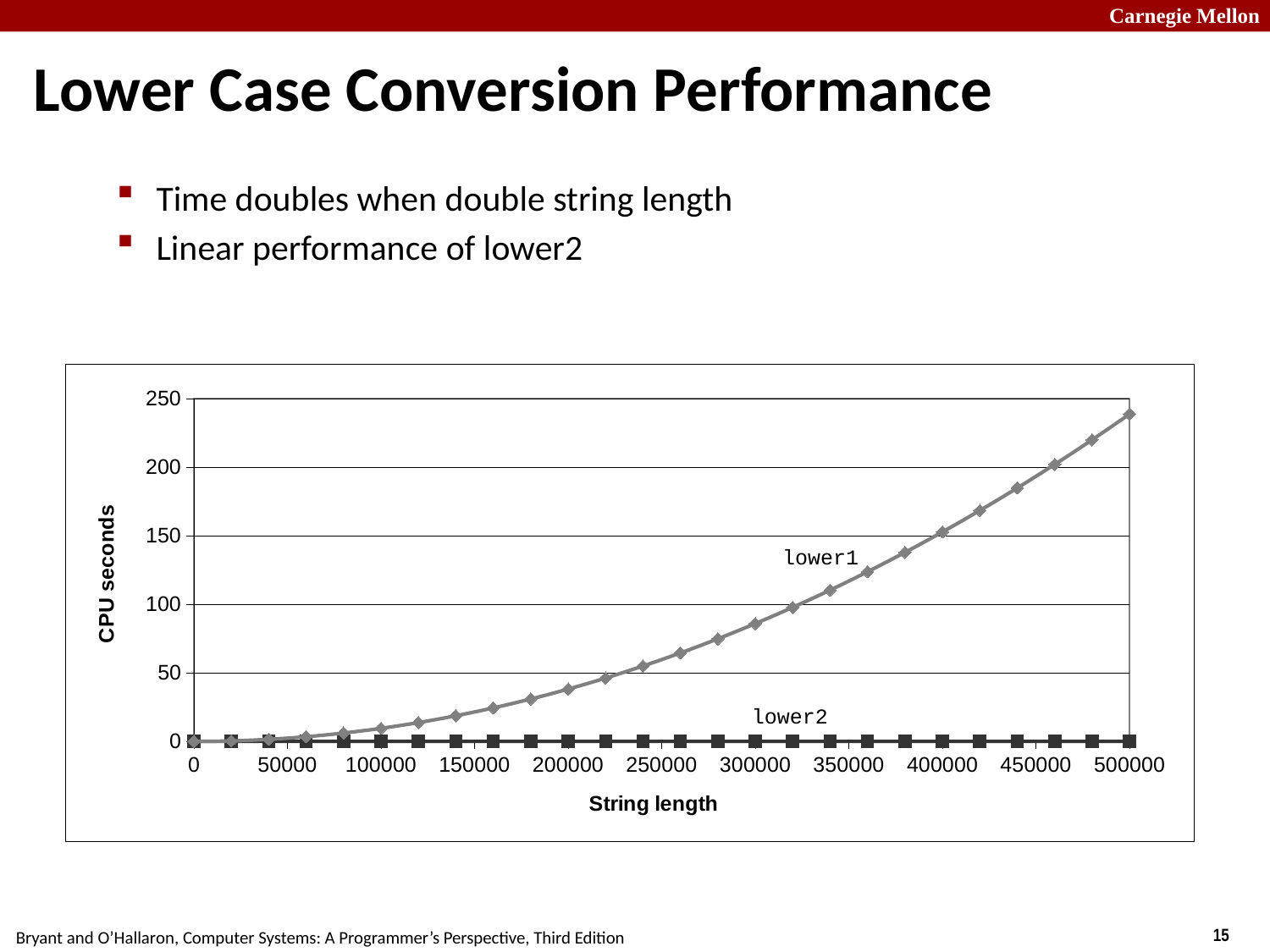
Is the value of lower1 at a string length of 300000 greater or less than 100? less Is the value of lower1 at a string length of 200000 greater or less than 50? less Is the value of lower2 at a string length of 500000 greater or less than 50? less What are the names of the two series plotted in the chart? lower1 and lower2 Does the CPU seconds value for lower1 rise or fall as string length increases? rise At a string length of 500000, which series has the larger CPU seconds value, lower1 or lower2? lower1 What is the label of the y axis? CPU seconds Which series reaches the highest CPU seconds value in the chart? lower1 How many data series are plotted in the chart? 2 What kind of chart is shown on the slide? line chart